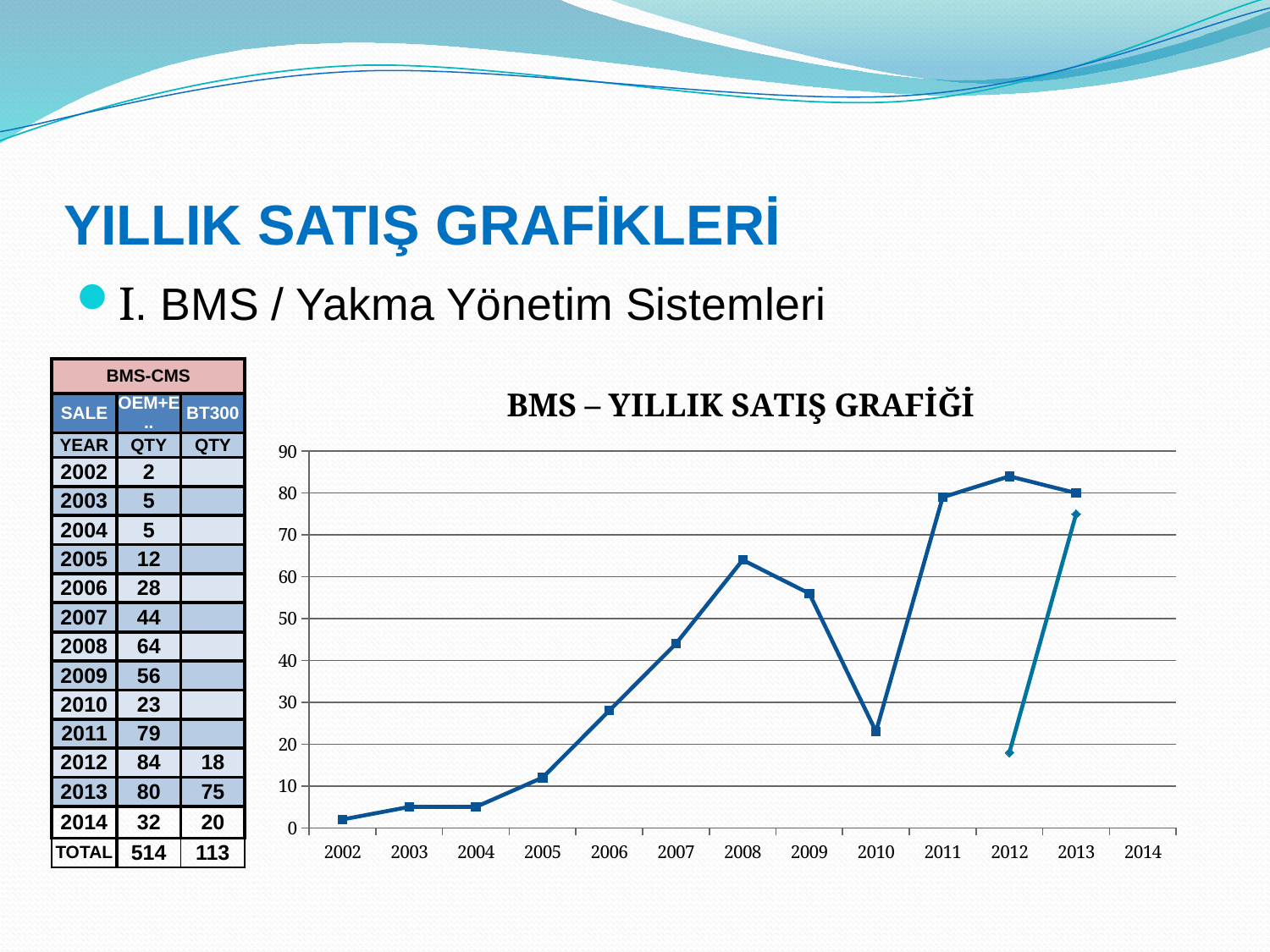
According to the table on the slide, what is the difference between the OEM QTY for 2012 and 2013? 4 In the BMS – YILLIK SATIŞ GRAFİĞİ chart, in which year does the main (OEM) line reach its highest point? 2012 What kind of chart is "BMS – YILLIK SATIŞ GRAFİĞİ"? line chart In the BMS – YILLIK SATIŞ GRAFİĞİ chart, does the main line rise or fall from 2005 to 2008? rise In the BMS – YILLIK SATIŞ GRAFİĞİ chart, is the main line's value for 2008 greater or less than 60? greater In the BMS – YILLIK SATIŞ GRAFİĞİ chart, is the second (shorter) line's value for 2013 greater or less than 70? greater In the BMS – YILLIK SATIŞ GRAFİĞİ chart, in which year is the main (OEM) line at its lowest point? 2002 In the BMS – YILLIK SATIŞ GRAFİĞİ chart, which year has the larger value on the main line, 2007 or 2009? 2009 What is the title of the chart on the slide? BMS – YILLIK SATIŞ GRAFİĞİ In the BMS – YILLIK SATIŞ GRAFİĞİ chart, is the main line's value for 2010 greater or less than 30? less How many years are shown on the x axis of the BMS – YILLIK SATIŞ GRAFİĞİ chart? 13 According to the table on the slide, what is the OEM QTY value for 2011? 79